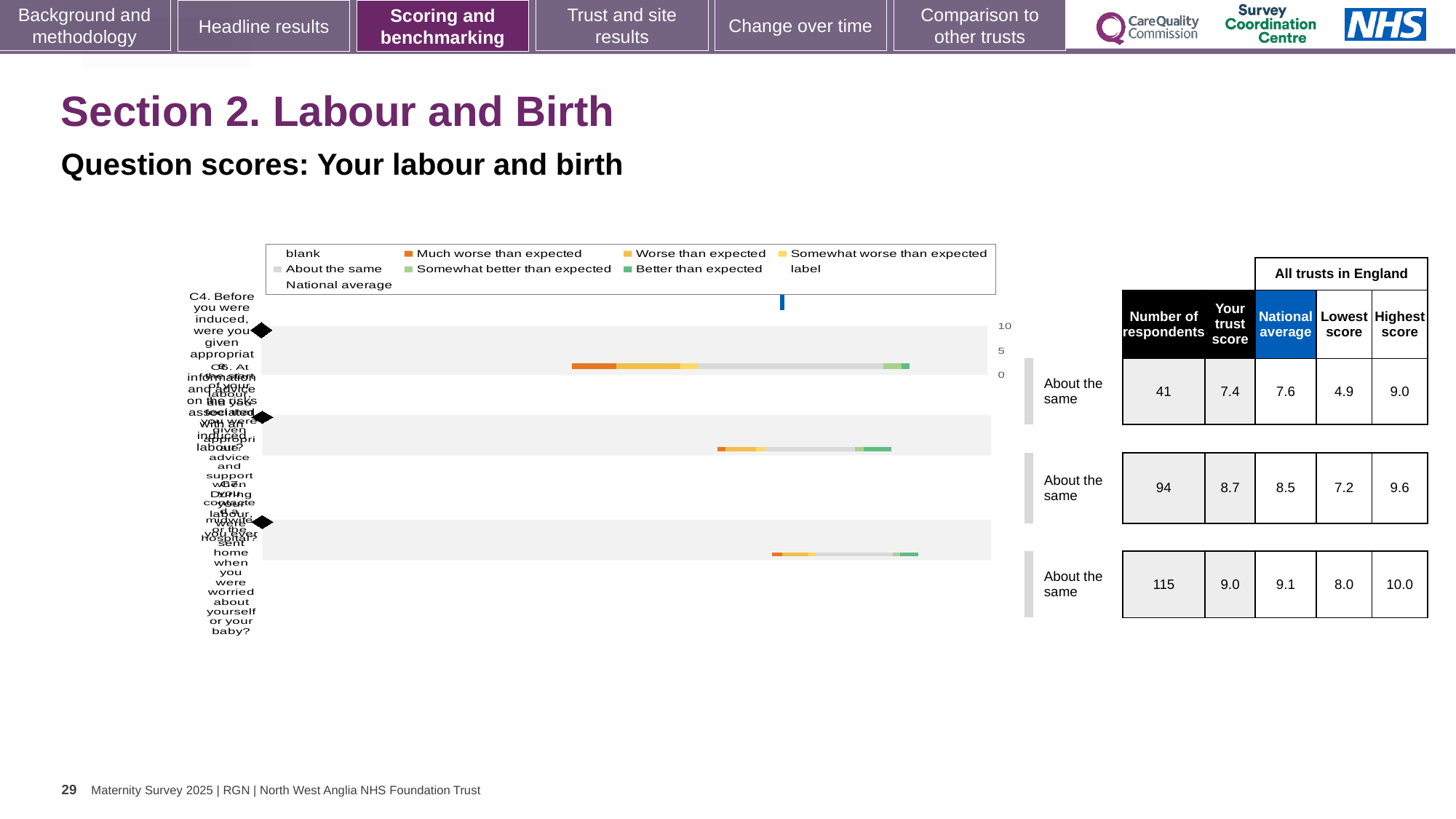
What is the highest score across all trusts in England for the bottom question row? 10.0 Which question row has the lowest trust score? the first (top) row What is the difference between the trust score and the national average for the middle question row? 0.2 What is the lowest score across all trusts in England for the top question row? 4.9 What kind of chart is shown on the slide? bar chart What is the national average for the third (bottom) question row? 9.1 What benchmark category is shown for each of the three question rows? About the same Is the trust score for the top question row larger or smaller than its national average? smaller What is the number of respondents for the first (top) question row? 41 Which question row has the highest number of respondents? the third (bottom) row What is the trust score for the second (middle) question row? 8.7 How many question rows are plotted in the chart? 3